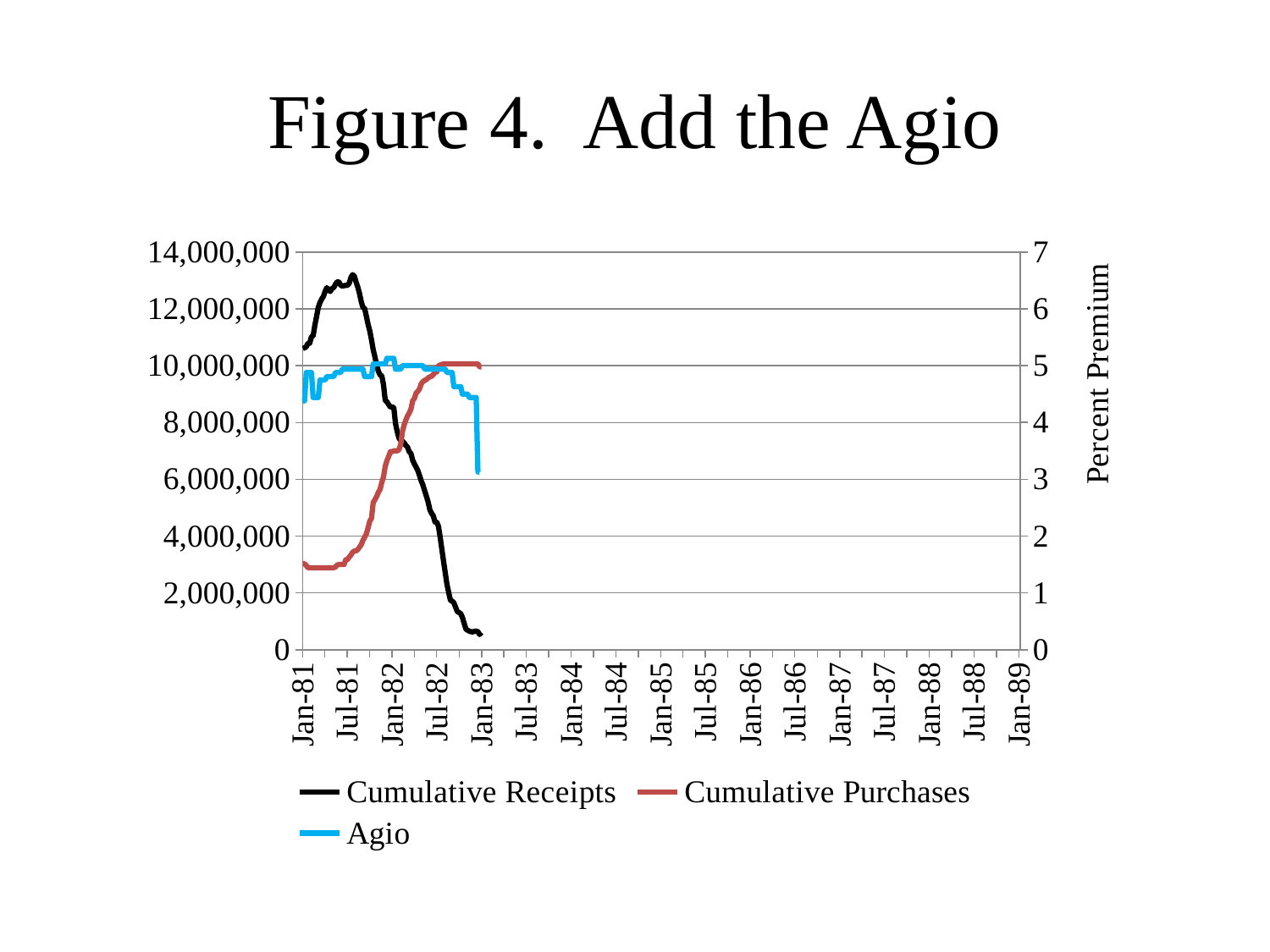
Is the final value of the Agio series (near Jan-83) greater or less than 4 on the right axis? less Which series reaches the highest value on the left axis? Cumulative Receipts Does the Cumulative Receipts series rise or fall overall from Jan-81 to Jan-83? Fall At Jan-81, which is larger: Cumulative Receipts or Cumulative Purchases? Cumulative Receipts What is the title of the chart on the slide? Figure 4. Add the Agio How many series does the legend list? 3 At Jan-83, which is larger: Cumulative Receipts or Cumulative Purchases? Cumulative Purchases Is the value for Cumulative Receipts at Jan-81 greater or less than 8,000,000? greater What kind of chart is shown on the slide? Line chart What is the label on the right-hand vertical axis? Percent Premium Does the Cumulative Purchases series rise or fall overall from Jan-81 to Jan-83? Rise Is the value for Cumulative Purchases at Jan-81 greater or less than 4,000,000? less